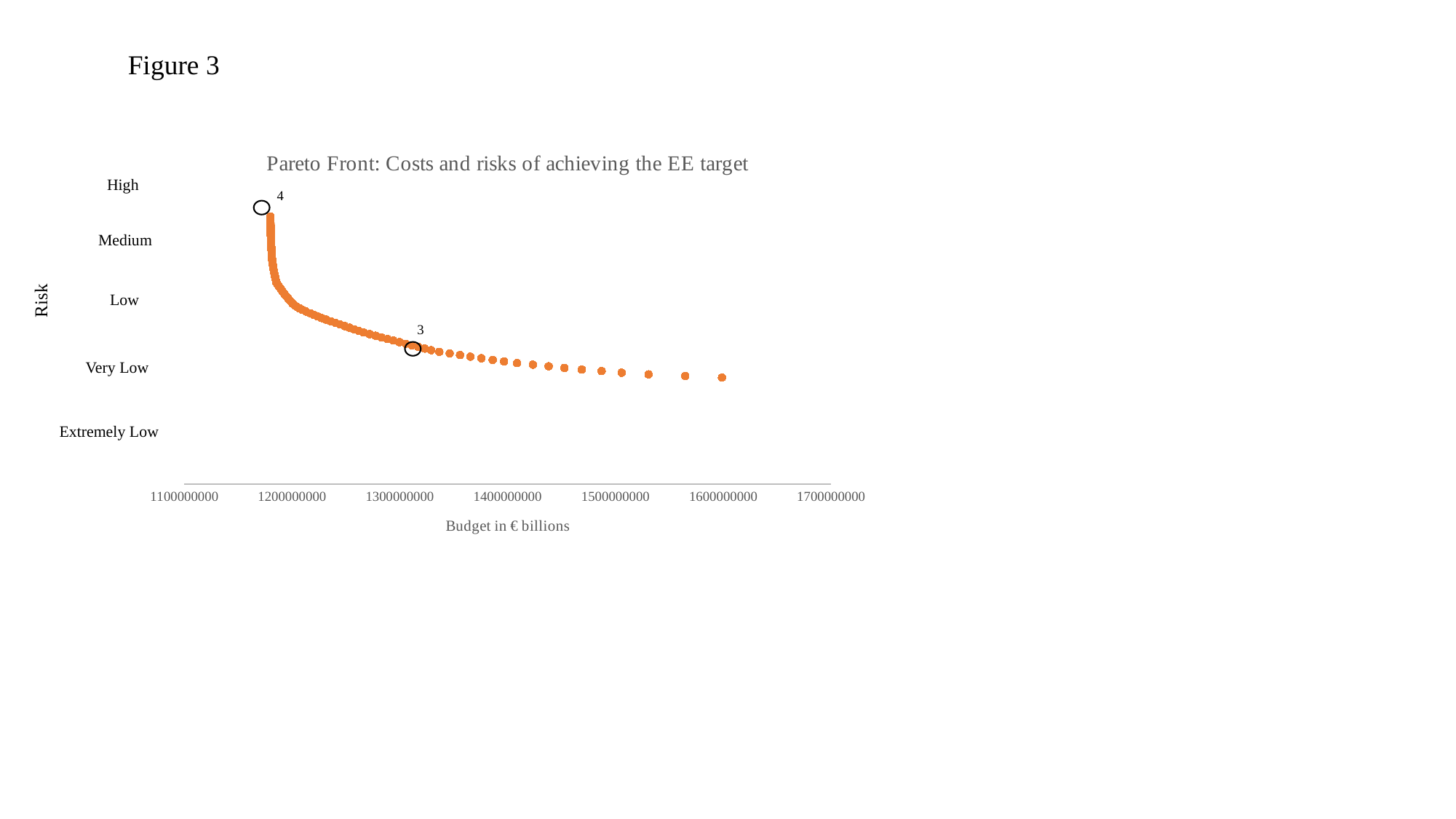
Which of the two labelled points, 3 or 4, has the larger budget? 3 Which labelled point has the highest risk level? 4 As the budget increases along the x axis, does the risk rise or fall? fall Is the budget for the point labelled 3 greater or less than 1300000000? greater How many risk levels are listed on the y axis? 5 What is the title of the chart? Pareto Front: Costs and risks of achieving the EE target What is the label of the x axis? Budget in € billions Is the budget for the point labelled 4 greater or less than 1200000000? less Is the budget for the point labelled 3 greater or less than 1400000000? less Which of the two labelled points, 3 or 4, has the higher risk? 4 What kind of chart is shown on the slide? scatter chart